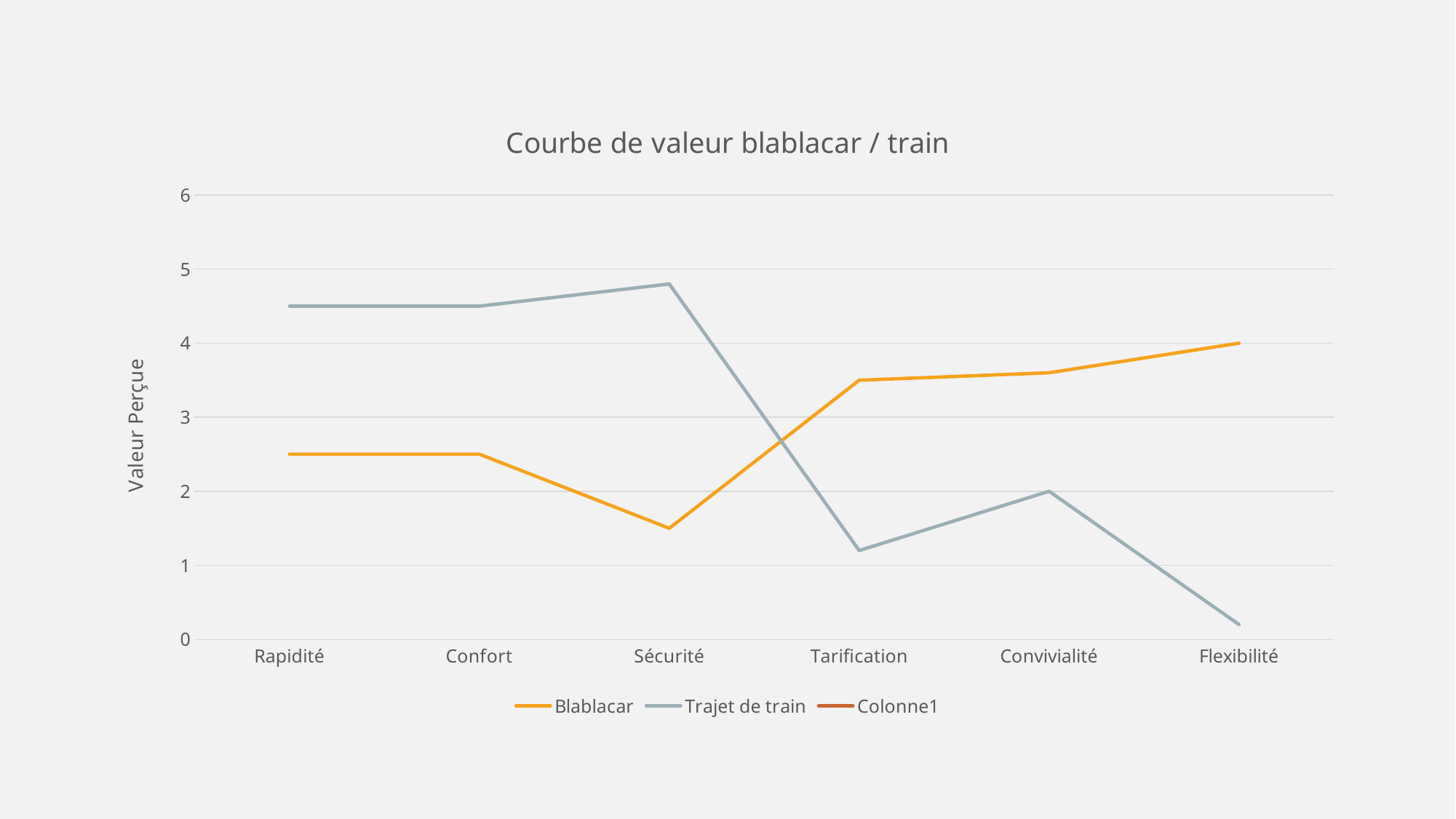
What is the value for Blablacar at Flexibilité? 4 What is the value for Trajet de train at Convivialité? 2 Is the value for Blablacar at Sécurité greater or less than 2? less What is the title of the chart? Courbe de valeur blablacar / train At Tarification, which series has the larger value, Blablacar or Trajet de train? Blablacar Is the value for Trajet de train at Flexibilité greater or less than 1? less At which category does the Trajet de train series reach its highest value? Sécurité How many series does the legend list? 3 What type of chart is shown on the slide? line chart Is the value for Trajet de train at Sécurité greater or less than 4? greater How many categories are shown on the x axis? 6 At which category does the Blablacar series reach its lowest value? Sécurité